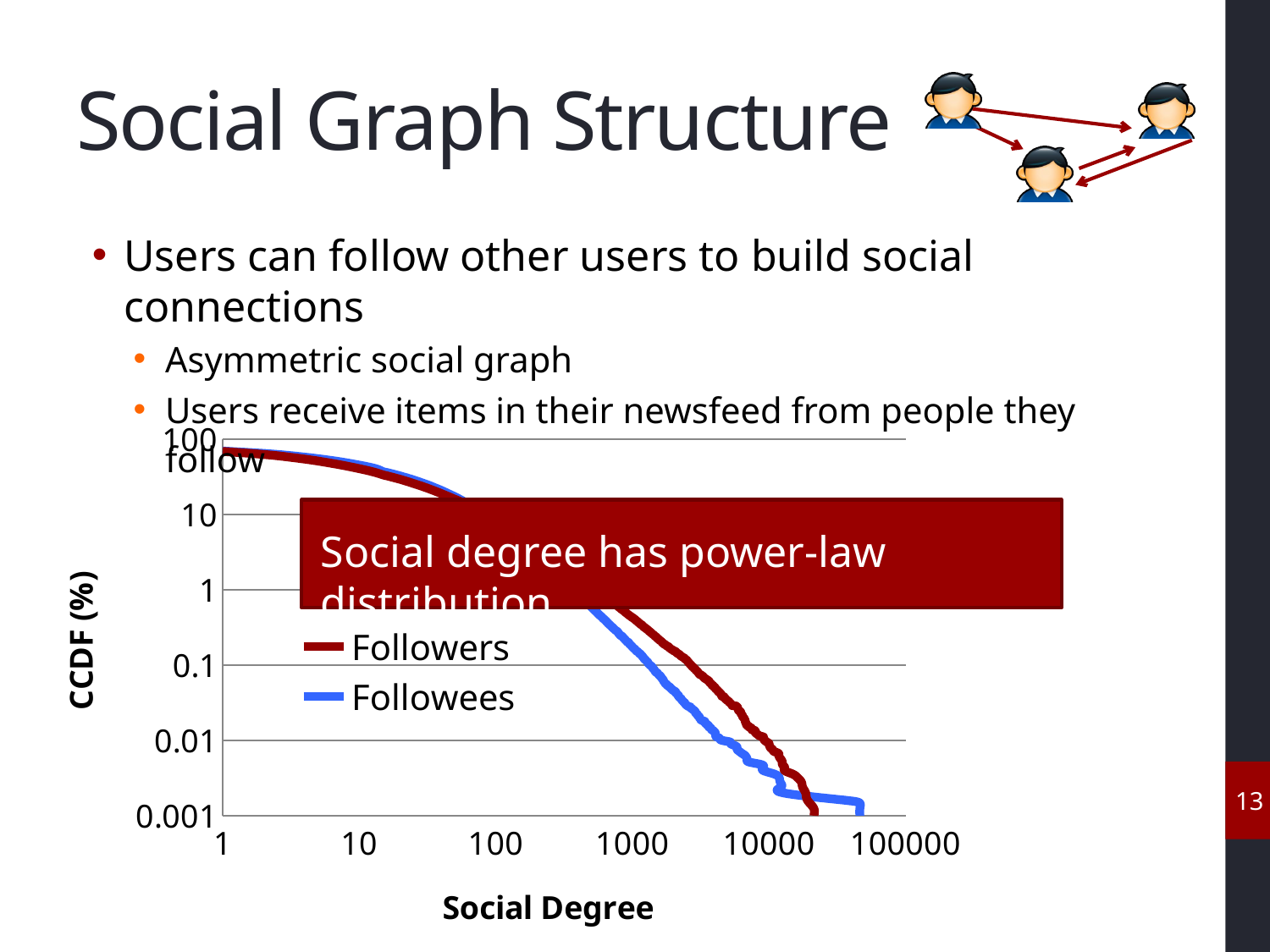
Is the CCDF value for Followees at a social degree of 10 greater or less than 10? greater At a social degree of 1000, which series has the higher CCDF value, Followers or Followees? Followers How many series does the legend list? 2 Is the CCDF value for Followers at a social degree of 1000 greater or less than 0.01? greater What are the two series named in the legend? Followers and Followees Is the CCDF value for Followers at a social degree of 10 greater or less than 10? greater Which series extends to a larger maximum social degree on the x axis, Followers or Followees? Followees Do the CCDF values rise or fall as social degree increases? fall What is the label of the x axis? Social Degree What kind of chart is shown on the slide? line chart